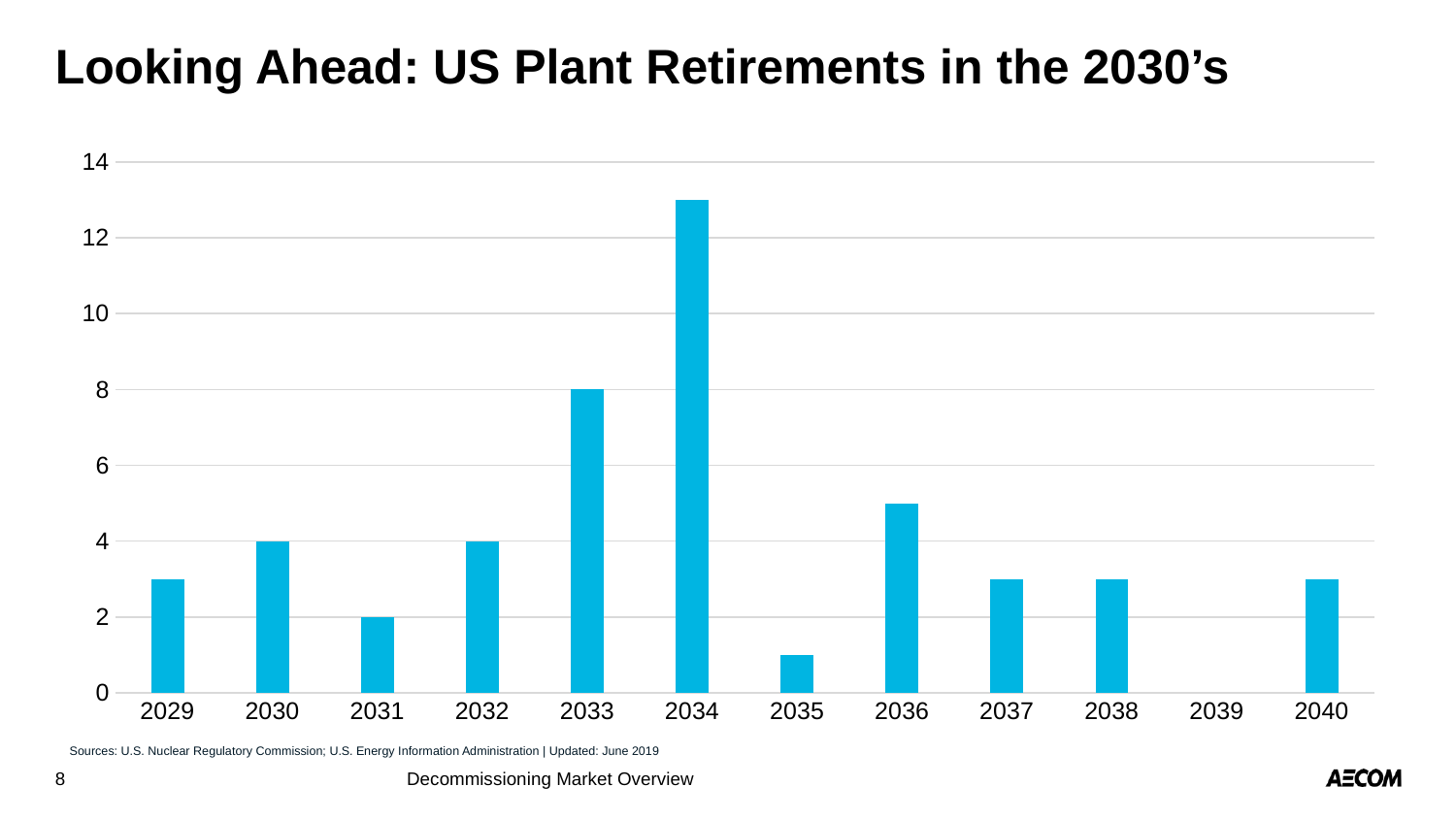
What is the value for 2031? 2 Is the value for 2035 greater or less than 2? less Which year has the lowest value among the years with a visible bar? 2035 How many years are shown on the x axis of the chart? 12 What is the title of the chart on the slide? Looking Ahead: US Plant Retirements in the 2030's Is the value for 2034 greater or less than 12? greater What is the difference between the values for 2033 and 2031? 6 Which year has the larger value, 2033 or 2036? 2033 What type of chart is shown on the slide? bar chart What is the value for 2033? 8 What is the value for 2030? 4 Which year has the highest value in the chart? 2034